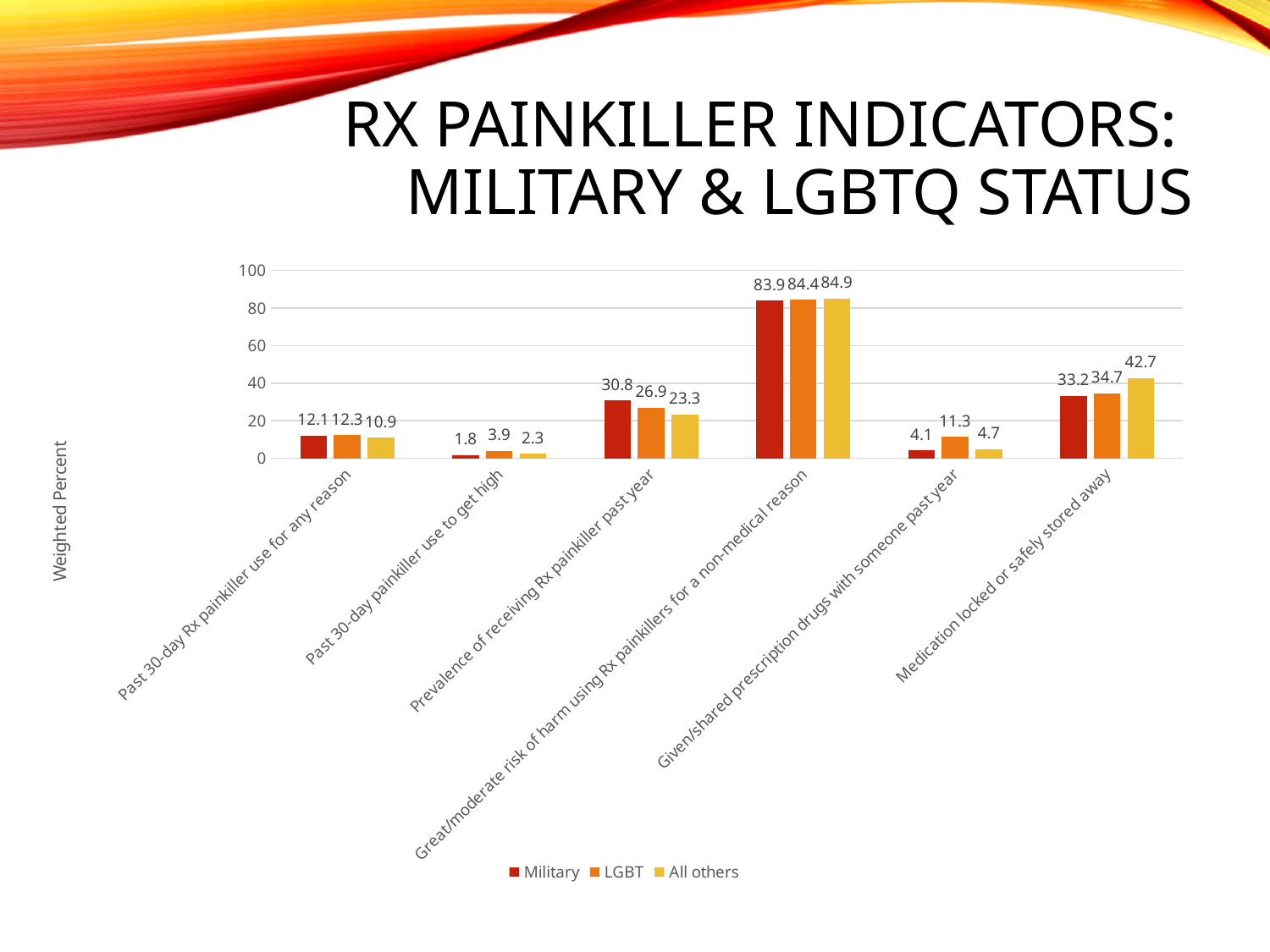
What is the All others value for 'Medication locked or safely stored away'? 42.7 What kind of chart is shown on the slide? Bar chart What is the difference between the Military and All others values for 'Prevalence of receiving Rx painkiller past year'? 7.5 How many categories are shown on the x axis? 6 Which category has the lowest LGBT value? Past 30-day painkiller use to get high How many series does the legend list? 3 What is the Military value for 'Past 30-day Rx painkiller use for any reason'? 12.1 Which category has the highest Military value? Great/moderate risk of harm using Rx painkillers for a non-medical reason What is the LGBT value for 'Given/shared prescription drugs with someone past year'? 11.3 For 'Given/shared prescription drugs with someone past year', which is larger: the LGBT value or the All others value? LGBT What is the label on the vertical axis? Weighted Percent Is the All others value for 'Medication locked or safely stored away' greater or less than 40? greater